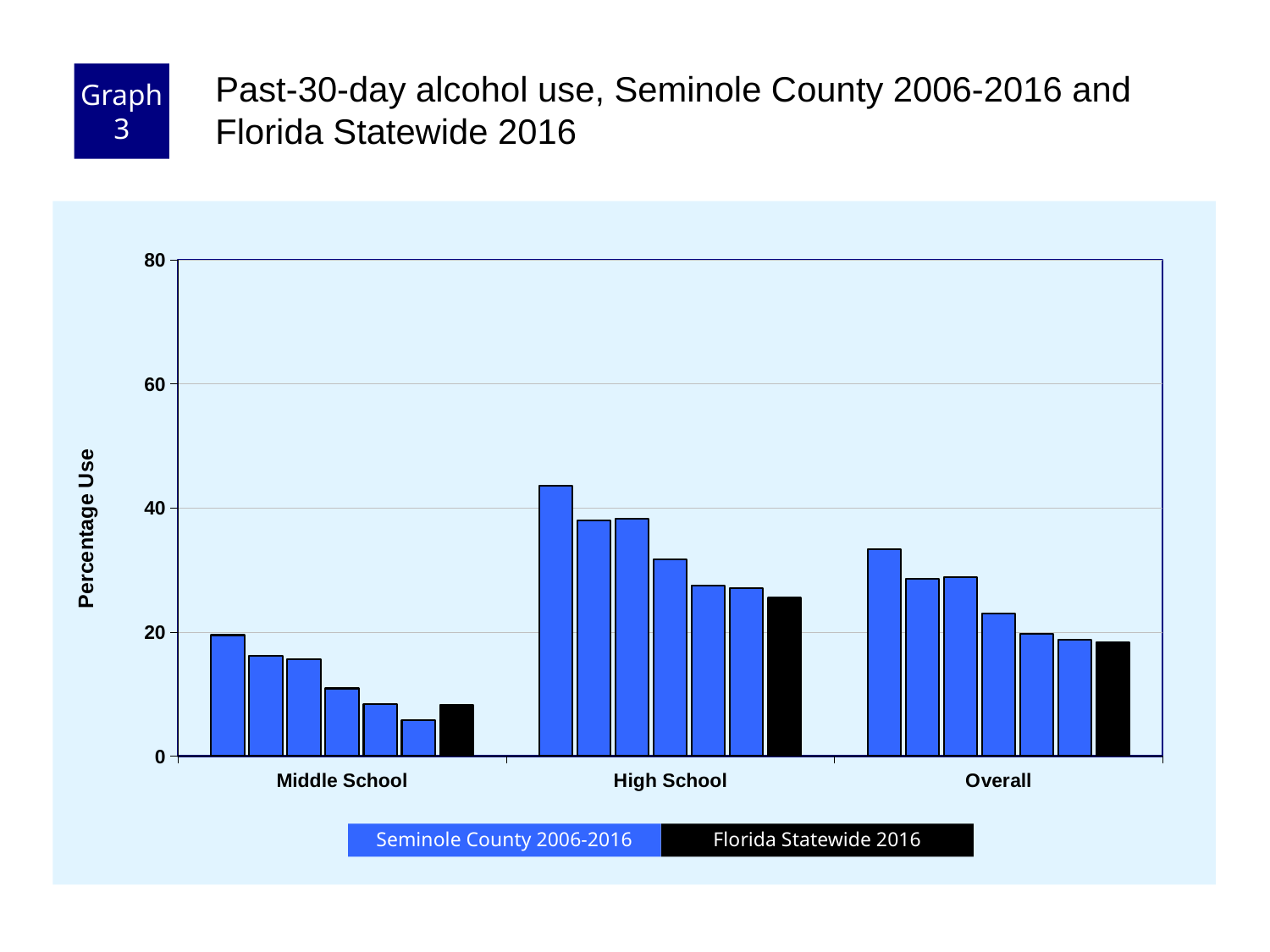
Which category has the highest bars overall? High School How many series does the legend list? 2 How many categories are shown on the x axis? 3 What is the label on the y axis? Percentage Use Which is larger, the Florida Statewide 2016 value for High School or for Overall? High School Is the Florida Statewide 2016 value for Middle School greater or less than 20? less Is the Florida Statewide 2016 value for High School greater or less than 20? greater Is the tallest Seminole County bar for High School greater or less than 40? greater Do the Seminole County 2006-2016 bars within the High School group rise or fall from left to right? fall Which category has the lowest bars overall? Middle School What kind of chart is shown on the slide? bar chart